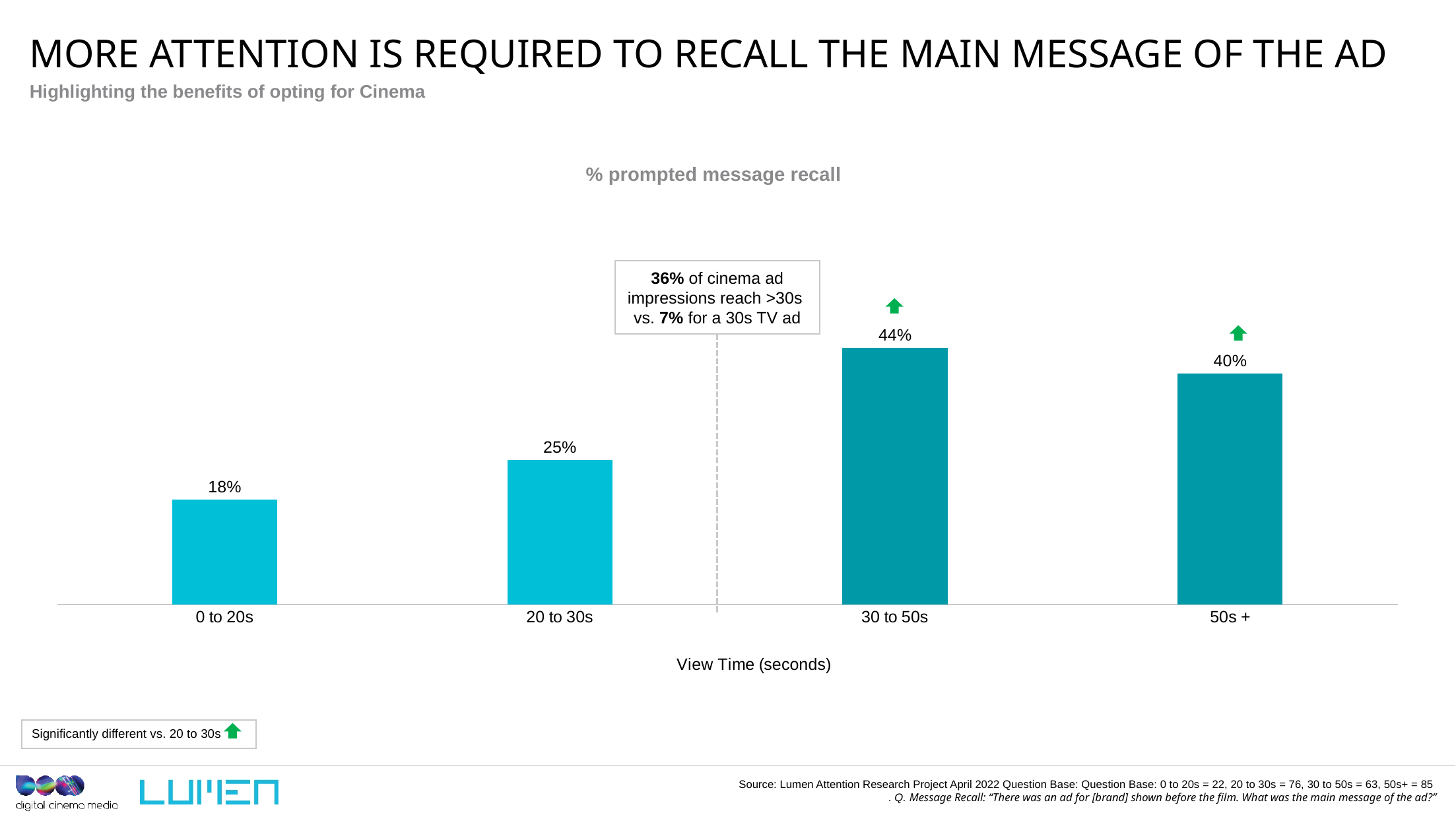
How many view time categories are shown in the chart? 4 Which view time category has the lowest % prompted message recall? 0 to 20s What is the difference in % prompted message recall between 50s + and 0 to 20s? 22% What is the % prompted message recall for the 30 to 50s view time? 44% What is the % prompted message recall for the 20 to 30s view time? 25% What is the % prompted message recall for the 0 to 20s view time? 18% What is the label of the x axis of the chart? View Time (seconds) What is the difference in % prompted message recall between 30 to 50s and 20 to 30s? 19% Which has a higher % prompted message recall, 30 to 50s or 50s +? 30 to 50s What is the % prompted message recall for the 50s + view time? 40% Which view time category has the highest % prompted message recall? 30 to 50s What type of chart is shown on the slide? Bar chart